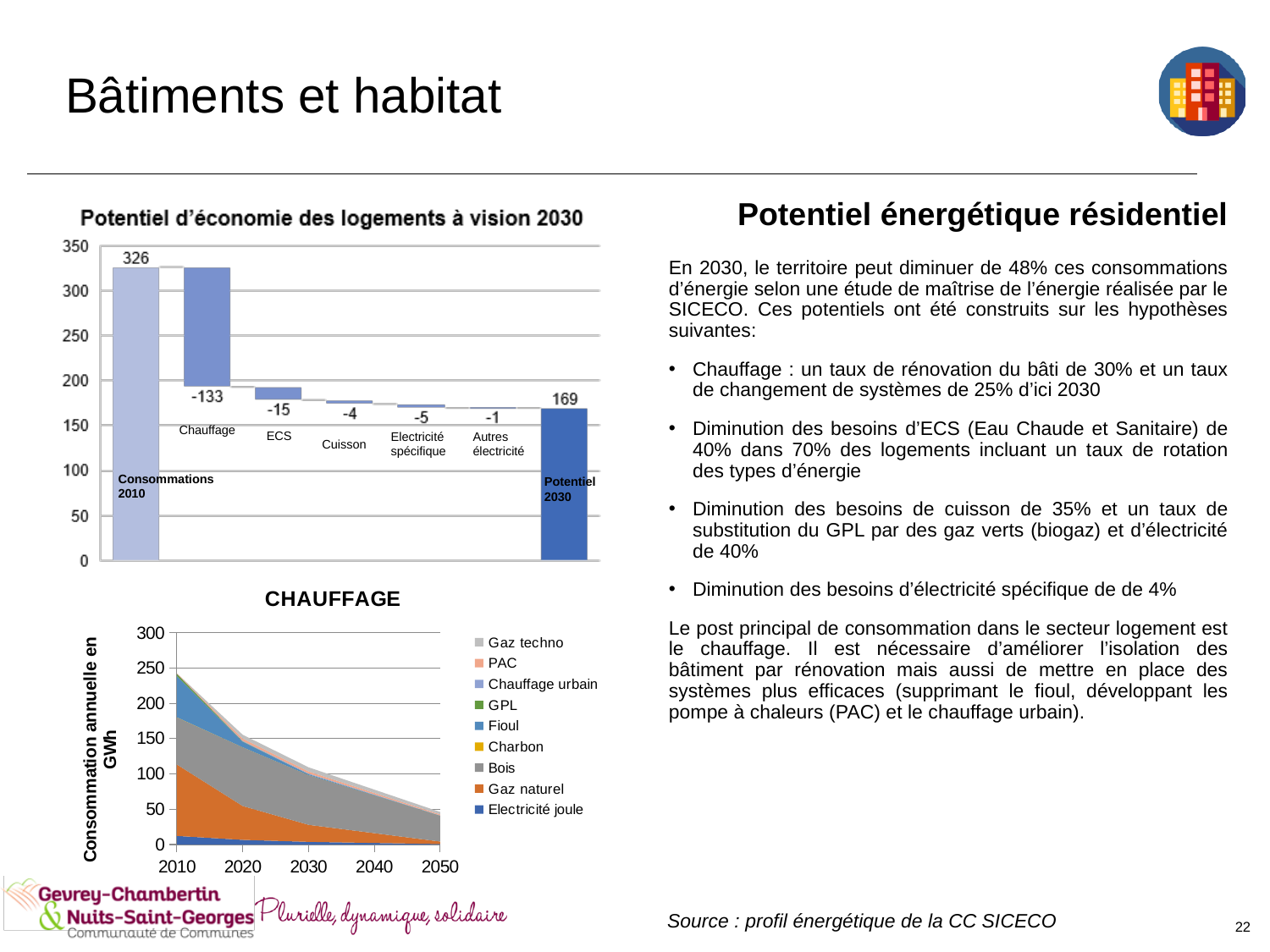
What kind of chart is the CHAUFFAGE chart? Stacked area chart In the chart 'Potentiel d'économie des logements à vision 2030', what is the value for Potentiel 2030? 169 In the chart 'Potentiel d'économie des logements à vision 2030', what is the value shown for ECS? -15 In the chart 'Potentiel d'économie des logements à vision 2030', what is the value shown for Chauffage? -133 In the chart 'Potentiel d'économie des logements à vision 2030', what is the difference between Consommations 2010 and Potentiel 2030? 157 In the CHAUFFAGE chart, is the total consumption in 2010 greater or less than 200? greater How many series does the legend of the CHAUFFAGE chart list? 9 In the chart 'Potentiel d'économie des logements à vision 2030', what is the value for Consommations 2010? 326 In the chart 'Potentiel d'économie des logements à vision 2030', which reduction item has the largest reduction? Chauffage In the chart 'Potentiel d'économie des logements à vision 2030', which reduction is larger: Cuisson or Electricité spécifique? Electricité spécifique In the chart 'Potentiel d'économie des logements à vision 2030', which reduction item has the smallest reduction? Autres électricité In the CHAUFFAGE chart, does total consumption rise or fall from 2010 to 2050? Fall